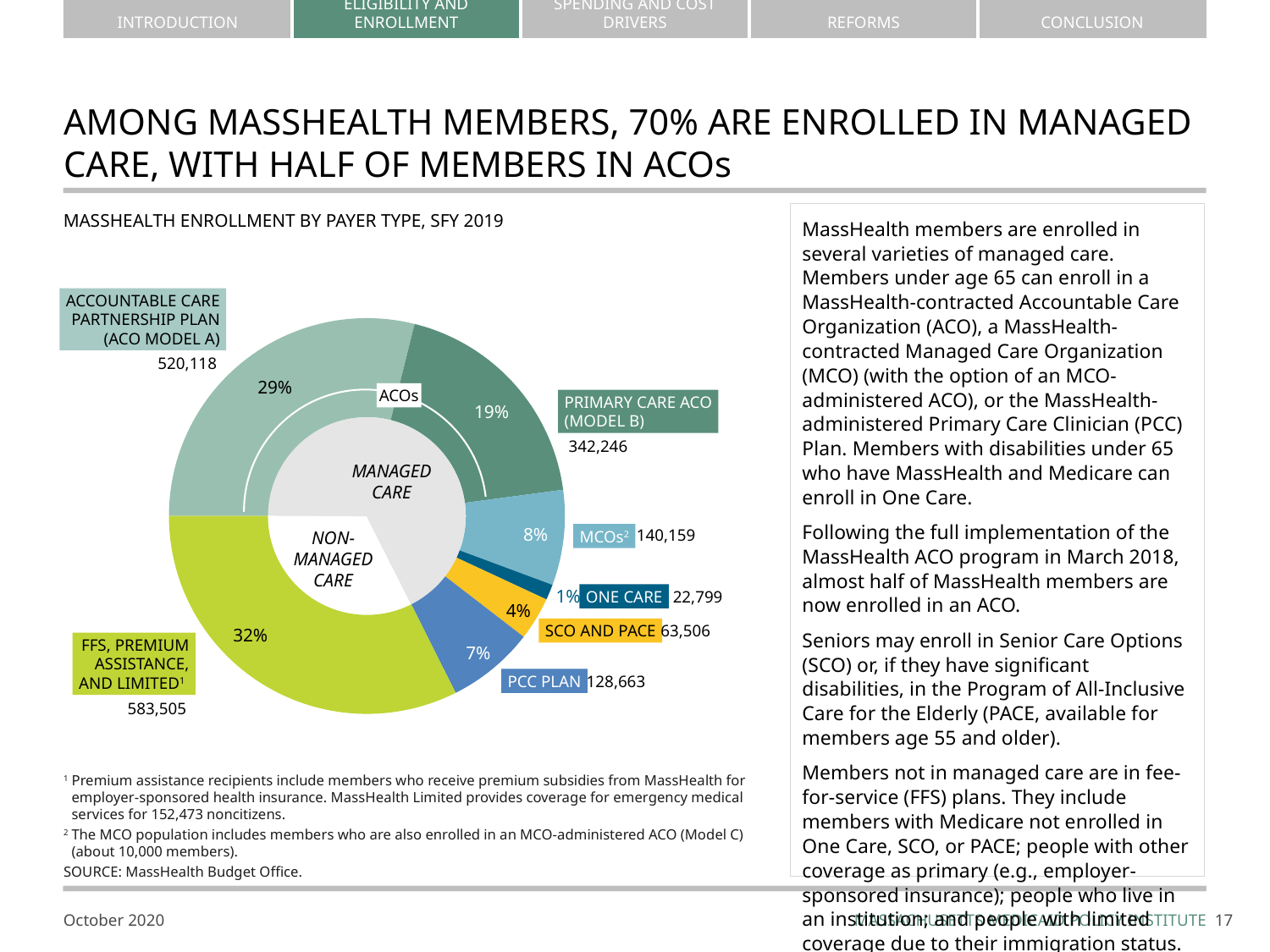
How many payer type categories are shown in the chart? 7 Which has more members, MCOs or the PCC Plan? MCOs What is the enrollment value shown for the Accountable Care Partnership Plan (ACO Model A)? 520,118 What is the enrollment value shown for SCO and PACE? 63,506 How many members are enrolled in One Care? 22,799 Which payer type has the smallest enrollment? One Care What kind of chart is used to show MassHealth enrollment by payer type? Doughnut (donut) chart What percentage of MassHealth enrollment is in the Primary Care ACO (Model B)? 19% Which payer type has the largest enrollment? FFS, Premium Assistance, and Limited What share of the pie does the PCC Plan represent? 7% What is the difference in enrollment between the FFS, Premium Assistance, and Limited group and the Accountable Care Partnership Plan (ACO Model A)? 63,387 What is the title of the chart? MassHealth Enrollment by Payer Type, SFY 2019